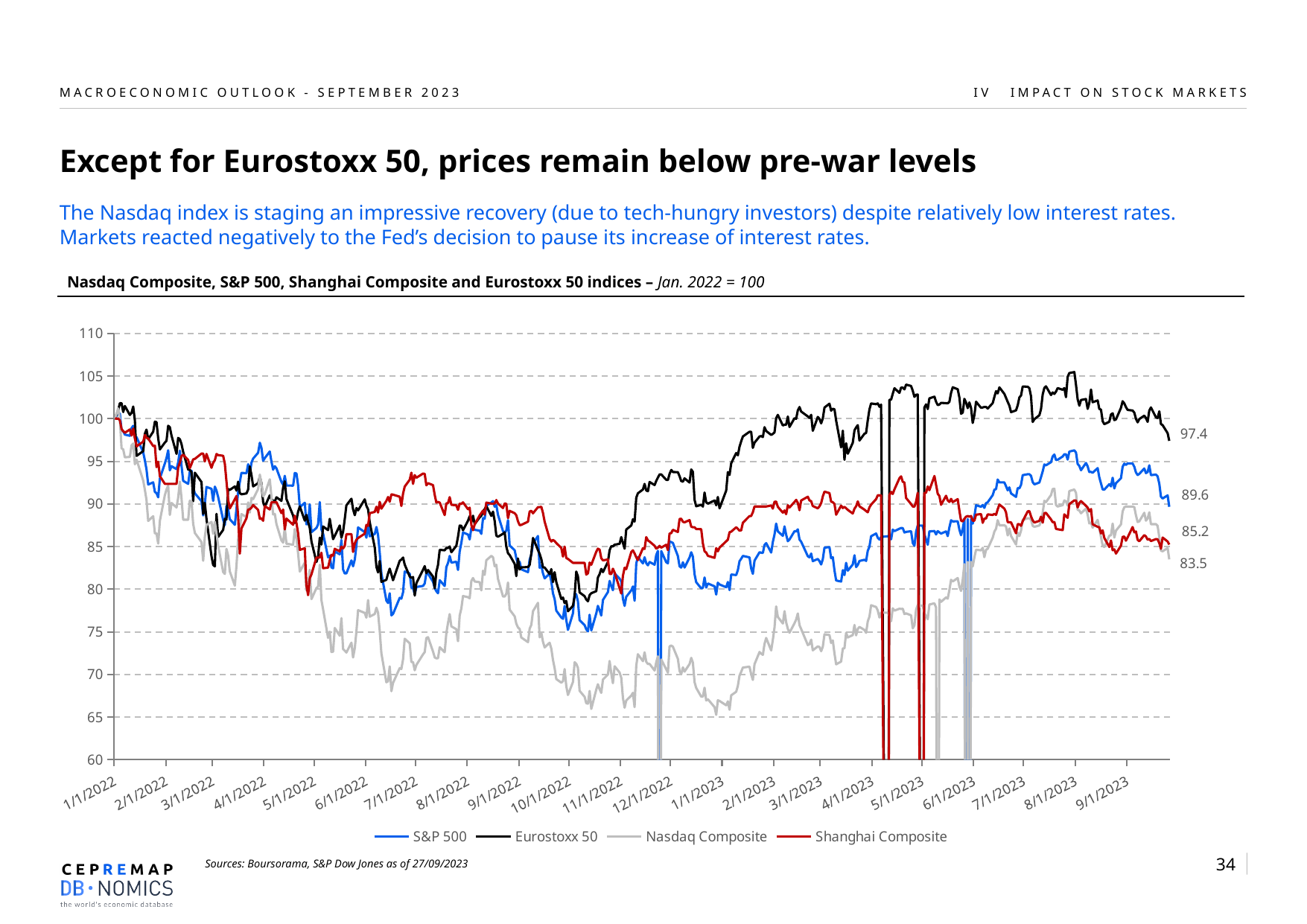
How many series does the legend list? 4 Which series has the highest value at the end of the chart? Eurostoxx 50 Which series has the lowest value at the end of the chart? Nasdaq Composite At the end of the chart, which is larger: the S&P 500 value or the Shanghai Composite value? S&P 500 What is the final labelled value of the Eurostoxx 50 series? 97.4 What base period is the index set to 100, according to the chart title? Jan. 2022 = 100 What is the final labelled value of the Nasdaq Composite series? 83.5 What kind of chart is shown on the slide? line chart What is the final labelled value of the S&P 500 series? 89.6 What is the difference between the final values of Eurostoxx 50 and S&P 500? 7.8 What is the final labelled value of the Shanghai Composite series? 85.2